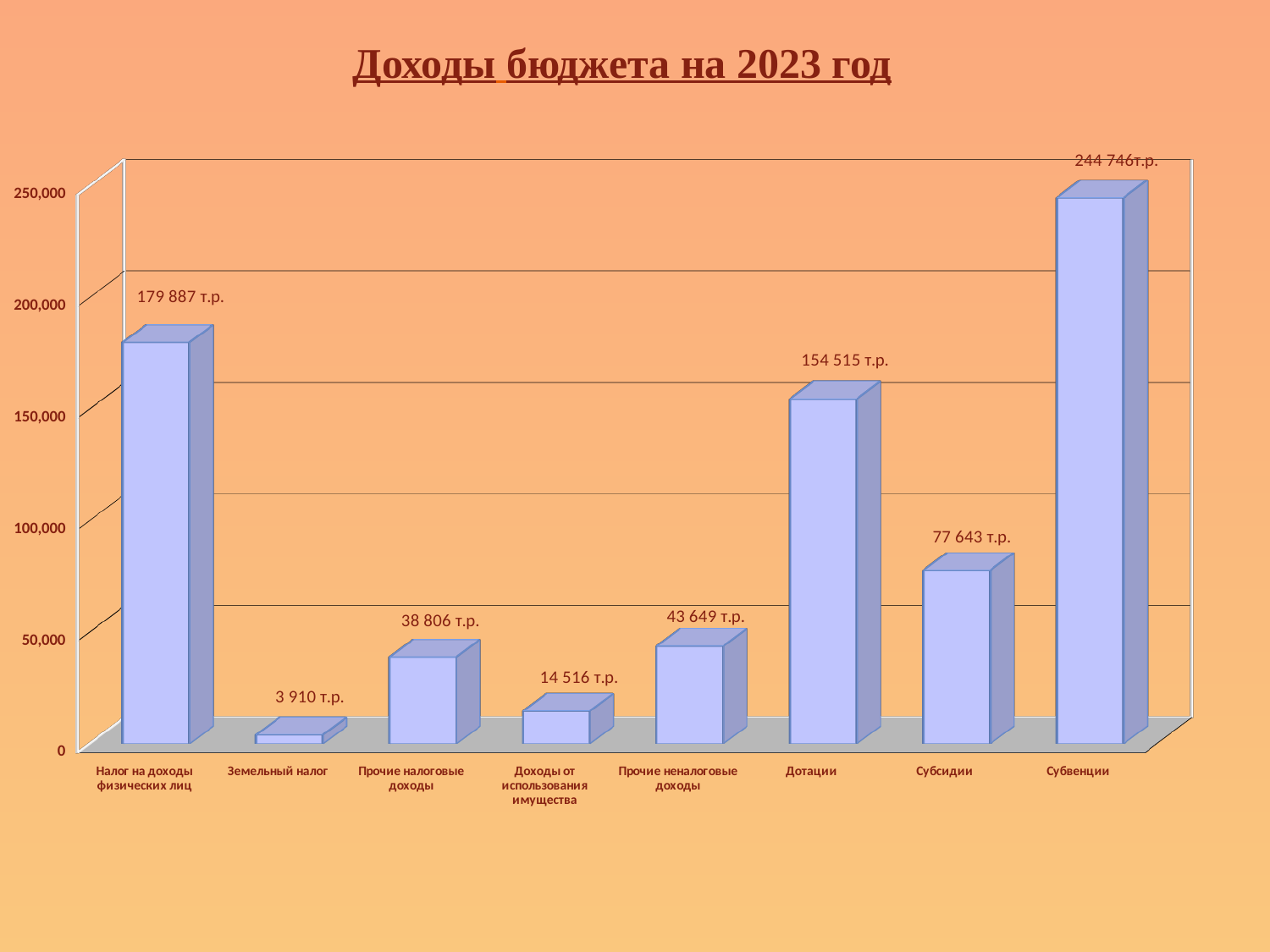
What is the value for Дотации? 154 515 т.р. Which category has the highest value? Субвенции What is the value for Налог на доходы физических лиц? 179 887 т.р. Which is larger, Прочие налоговые доходы or Прочие неналоговые доходы? Прочие неналоговые доходы Is the value for Дотации greater or less than 150,000? greater How many categories are shown on the chart? 8 What is the title of the chart? Доходы бюджета на 2023 год Which category has the lowest value? Земельный налог What is the value for Земельный налог? 3 910 т.р. What is the difference between Субвенции and Налог на доходы физических лиц? 64 859 т.р. What is the difference between Дотации and Субсидии? 76 872 т.р. What is the value for Субсидии? 77 643 т.р.